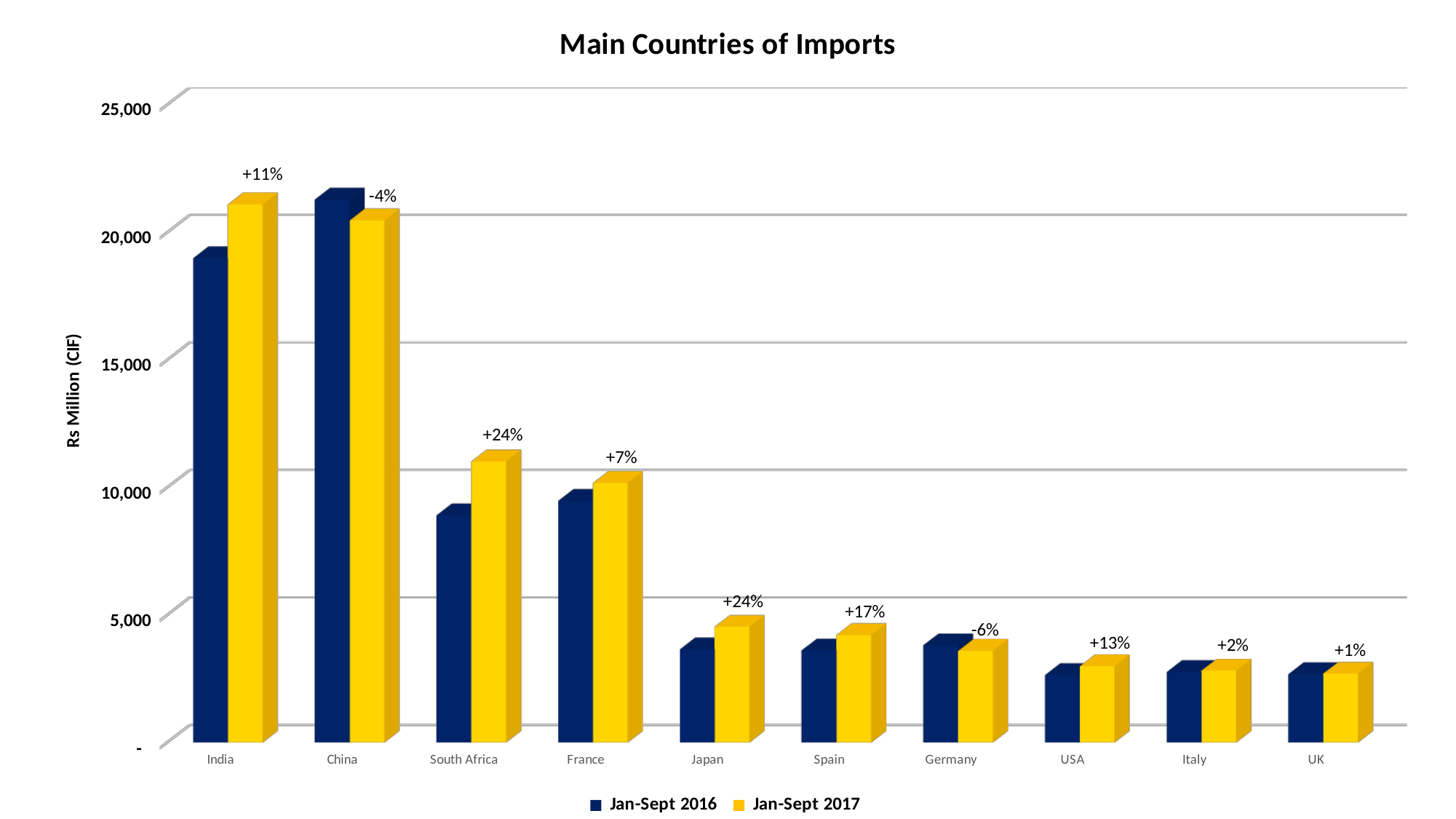
Is the Jan-Sept 2017 value for South Africa greater or less than 10,000? greater Which country has the highest Jan-Sept 2016 value? China How many series does the legend list? 2 What kind of chart is shown on the slide? bar chart What percentage change is labelled above the bars for USA? +13% How many countries are shown on the x axis of the chart? 10 Is the Jan-Sept 2016 value for India greater or less than 20,000? less Is the Jan-Sept 2017 value for Japan greater or less than 5,000? less What percentage change is labelled above the bars for South Africa? +24% What percentage change is labelled above the bars for Germany? -6% What is the title of the vertical axis? Rs Million (CIF) What percentage change is labelled above the bars for China? -4%